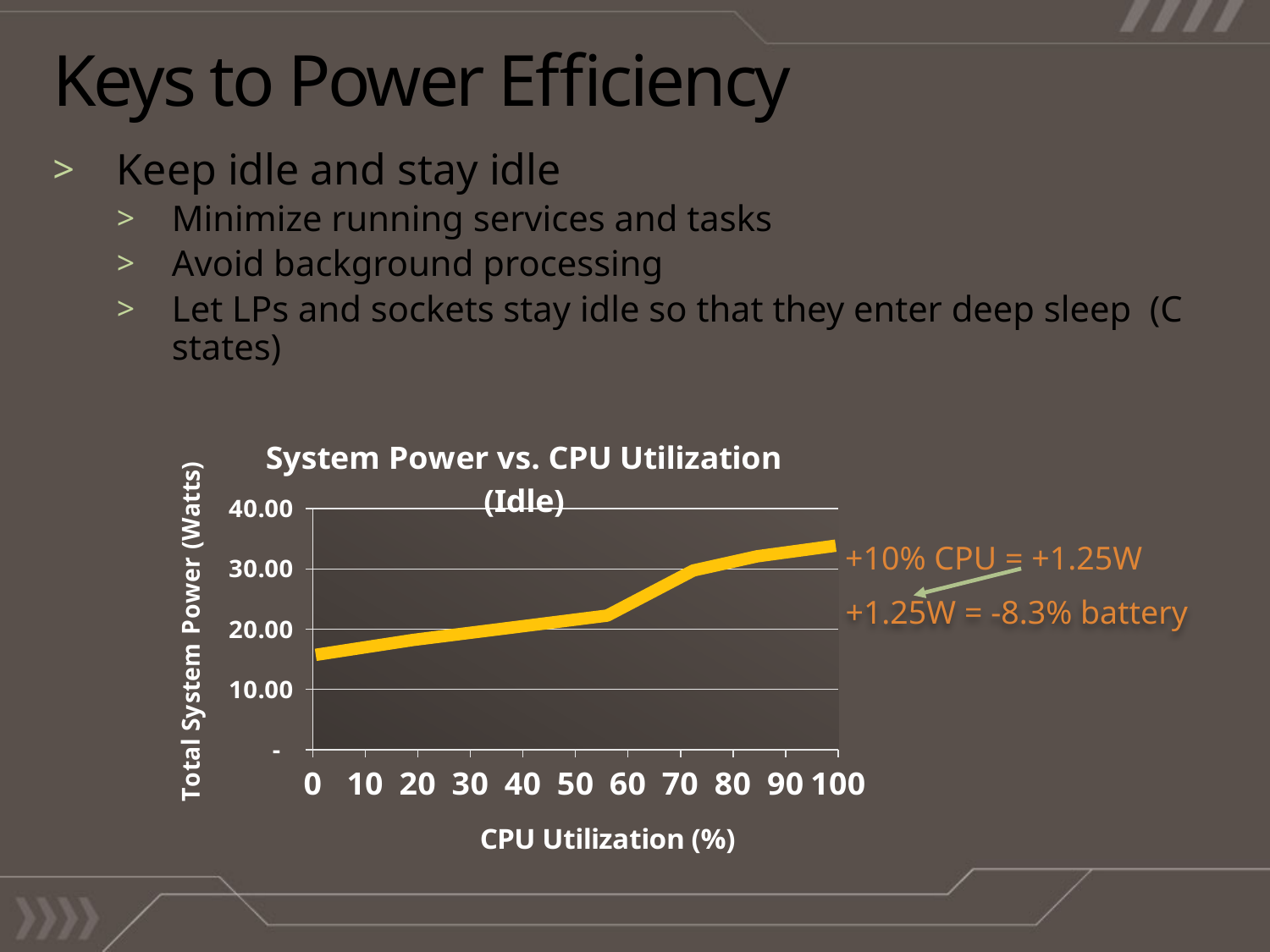
Which CPU utilization level has the highest total system power, 0 or 100? 100 Is the total system power at 0% CPU utilization greater or less than 20.00? less How many tick labels are shown on the CPU Utilization (%) axis? 11 What is the label of the y axis of the chart? Total System Power (Watts) What kind of chart is shown on the slide? line chart Is the total system power at 100% CPU utilization greater or less than 30.00? greater Is the total system power at 70% CPU utilization greater or less than 20.00? greater Does total system power rise or fall as CPU utilization increases from 0 to 100? rise What is the title of the chart? System Power vs. CPU Utilization (Idle)